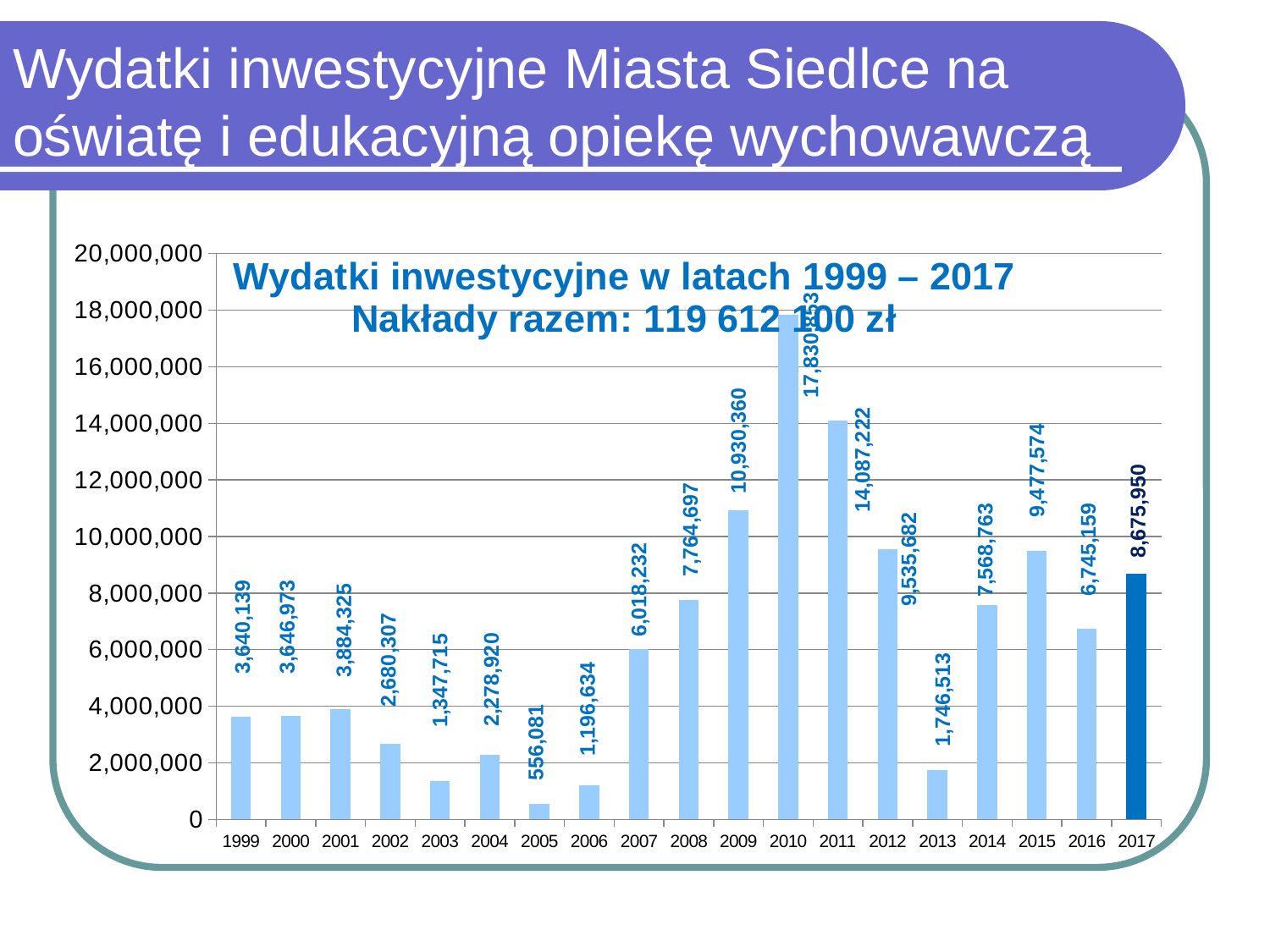
How many years are shown on the x axis of the chart? 19 Which year has the lowest investment expenditure? 2005 Which year has the highest investment expenditure? 2010 By how much does the value for 2017 exceed the value for 2016? 1,930,791 What is the value shown for 2011? 14,087,222 What is the investment expenditure value shown for 2017? 8,675,950 What type of chart is shown on the slide? Bar chart What value is labelled on the bar for 2005? 556,081 What is the difference between the values for 2011 and 2009? 3,156,862 Which year has the larger value, 2007 or 2016? 2016 Is the value for 2009 greater or less than 10,000,000? greater What value is shown for 2013? 1,746,513